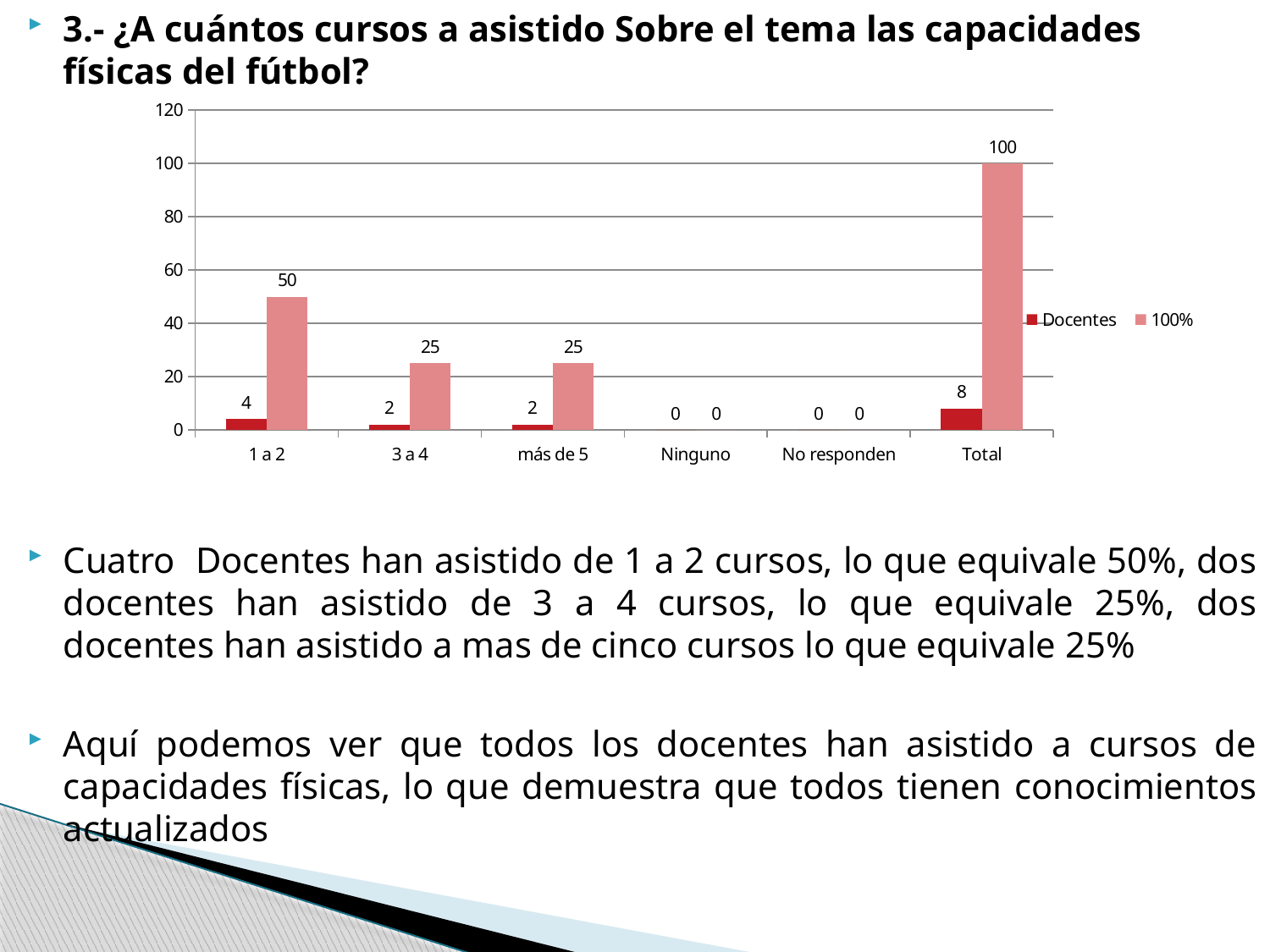
What are the two series names listed in the legend? Docentes and 100% Which is larger: the Docentes value for '1 a 2' or the Docentes value for '3 a 4'? 1 a 2 What is the 100% series value for the category '3 a 4'? 25 Excluding the Total category, which category has the highest 100% series value? 1 a 2 What is the 100% series value for the 'Total' category? 100 How many categories are shown on the x axis? 6 What is the Docentes value for the 'Total' category? 8 What kind of chart is shown on the slide? bar chart What is the difference between the 100% series values for '1 a 2' and 'más de 5'? 25 Is the 100% series value for '1 a 2' greater or less than 40? greater What is the Docentes value for the category '1 a 2'? 4 How many series does the legend list? 2